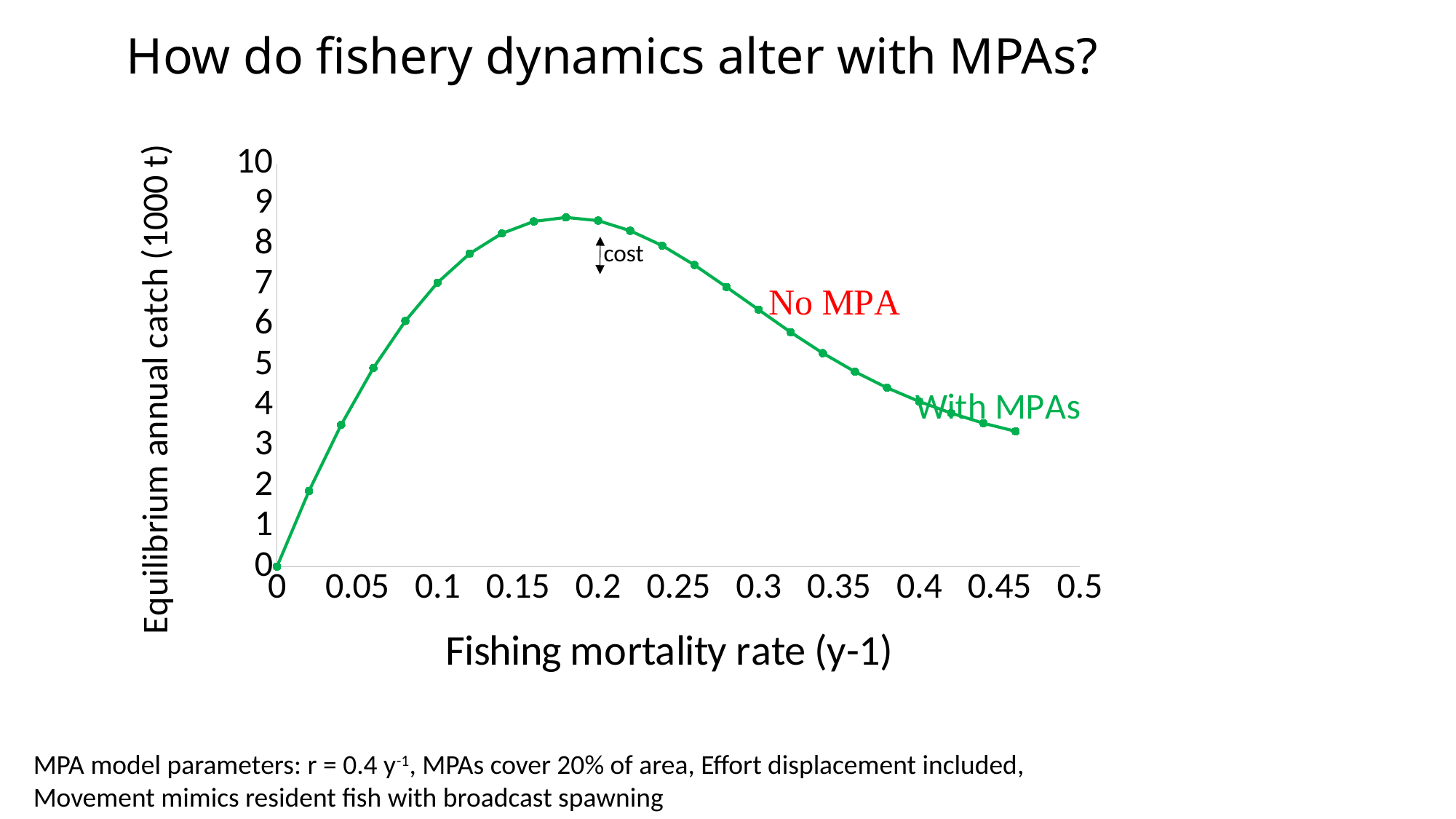
How does the equilibrium annual catch change as the fishing mortality rate increases from 0 to 0.5? It rises to a peak and then falls Which has a higher equilibrium annual catch: a fishing mortality rate of 0.1 or 0.4? 0.1 What is the title of the y-axis? Equilibrium annual catch (1000 t) What is the equilibrium annual catch at a fishing mortality rate of 0? 0 Is the equilibrium annual catch at a fishing mortality rate of 0.2 greater or less than 8? greater What type of chart is shown on the slide? Line chart Is the equilibrium annual catch at a fishing mortality rate of 0.1 greater or less than 6? greater Is the equilibrium annual catch at a fishing mortality rate of 0.46 greater or less than 4? less At which fishing mortality rate is the equilibrium annual catch lowest? 0 What is the highest value shown on the y-axis? 10 What is the title of the x-axis? Fishing mortality rate (y-1)